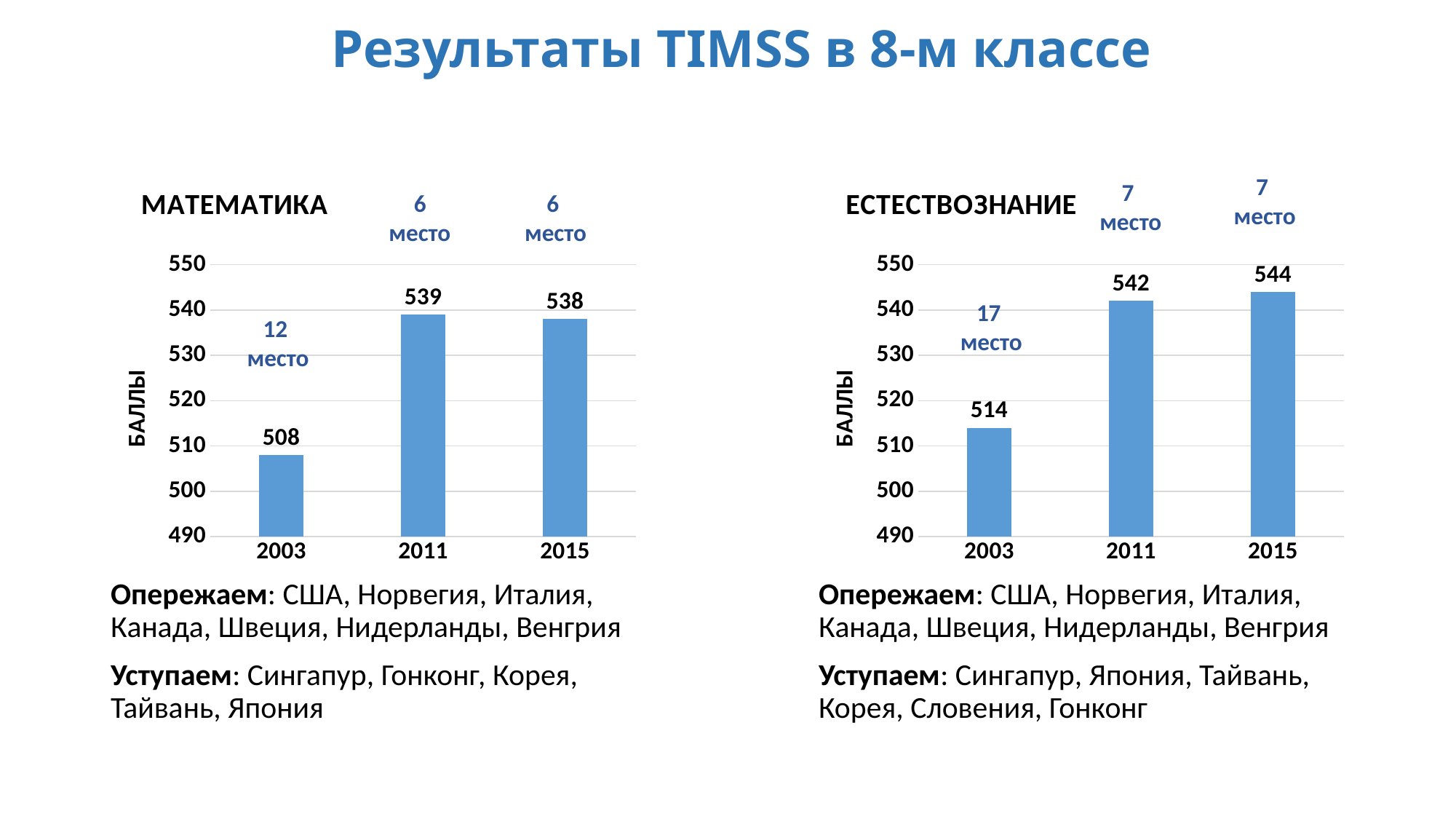
In the МАТЕМАТИКА chart, what is the value for 2011? 539 In the МАТЕМАТИКА chart, which year has the highest value? 2011 In the ЕСТЕСТВОЗНАНИЕ chart, what is the difference between the values for 2015 and 2011? 2 How many bars are in the МАТЕМАТИКА chart? 3 In the МАТЕМАТИКА chart, what is the value for 2003? 508 In the ЕСТЕСТВОЗНАНИЕ chart, which year has the lowest value? 2003 In the ЕСТЕСТВОЗНАНИЕ chart, what is the value for 2003? 514 In the ЕСТЕСТВОЗНАНИЕ chart, is the value for 2003 greater or less than 520? less In the МАТЕМАТИКА chart, what is the difference between the values for 2011 and 2003? 31 In the ЕСТЕСТВОЗНАНИЕ chart, what is the value for 2015? 544 In the ЕСТЕСТВОЗНАНИЕ chart, do the values rise or fall from 2003 to 2015? rise What type of chart is the ЕСТЕСТВОЗНАНИЕ chart? bar chart